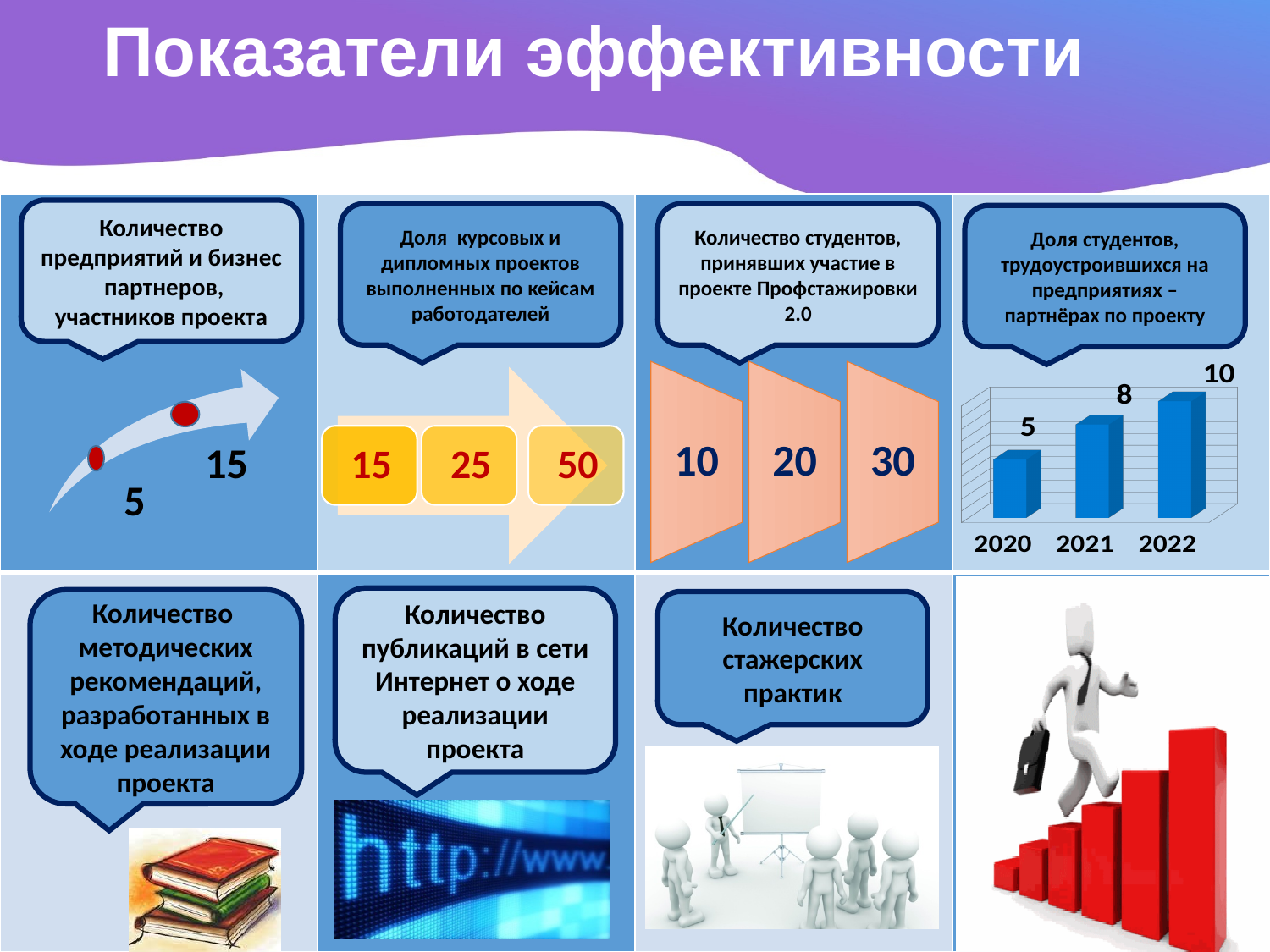
In the bar chart in the top-right panel, what is the difference between the values for 2021 and 2020? 3 In the bar chart in the top-right panel, do the values rise or fall from 2020 to 2022? Rise What kind of chart is shown in the top-right panel of the slide? Bar chart In the bar chart titled "Доля студентов, трудоустроившихся на предприятиях – партнёрах по проекту", what is the value for 2022? 10 In the bar chart titled "Доля студентов, трудоустроившихся на предприятиях – партнёрах по проекту", what is the value for 2020? 5 In the bar chart in the top-right panel, which year has the highest value? 2022 In the bar chart titled "Доля студентов, трудоустроившихся на предприятиях – партнёрах по проекту", what is the value for 2021? 8 In the bar chart in the top-right panel, what is the difference between the values for 2022 and 2020? 5 In the bar chart in the top-right panel, which is larger: the value for 2021 or the value for 2022? 2022 How many bars are shown in the bar chart in the top-right panel? 3 What is the title of the slide containing the bar chart? Показатели эффективности In the bar chart in the top-right panel, which year has the lowest value? 2020